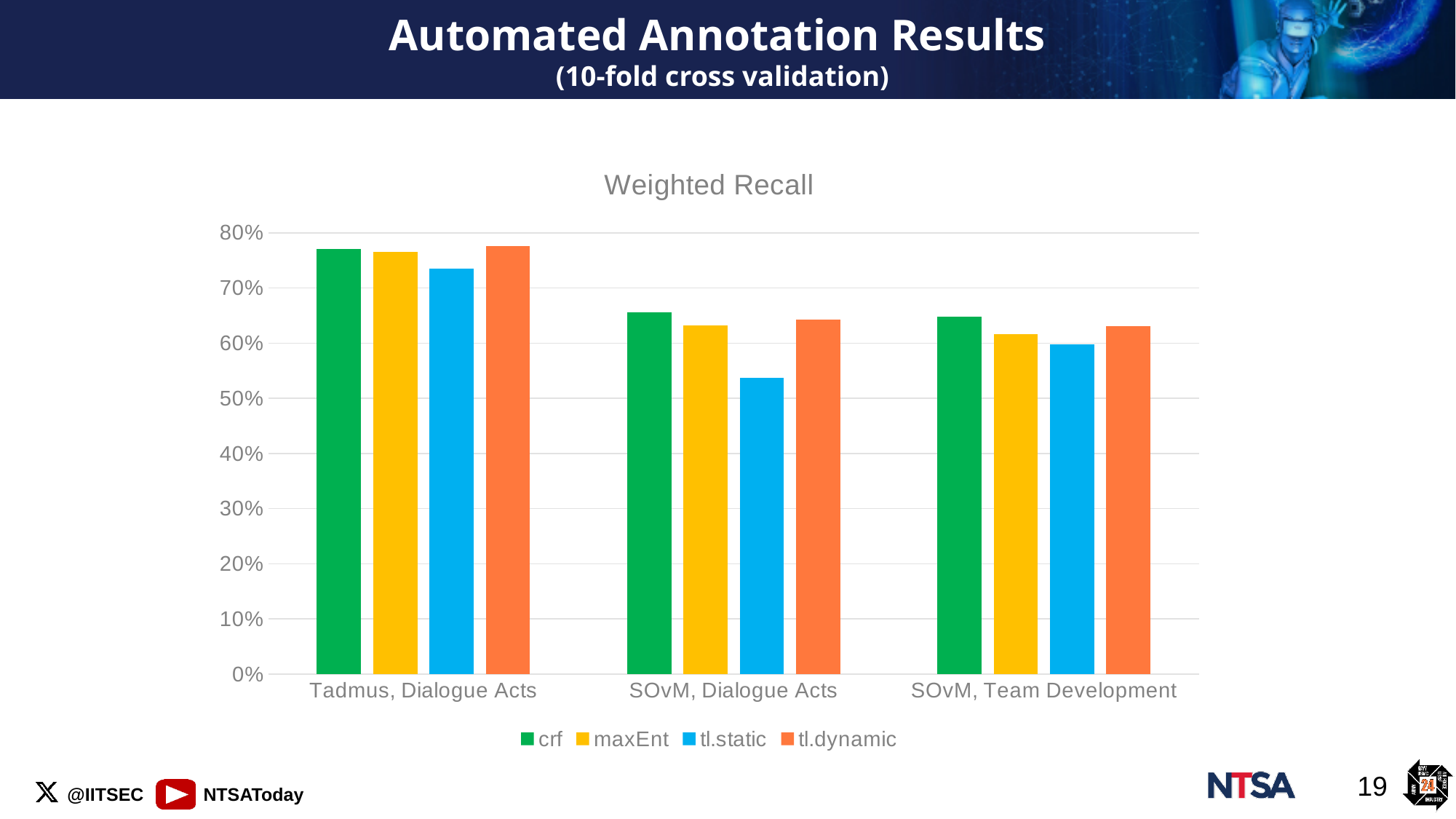
Is the tl.static value for SOvM, Dialogue Acts greater or less than 60%? less In the SOvM, Dialogue Acts category, which is larger: crf or tl.static? crf Which series is shown in orange in the legend? tl.dynamic Which series has the lowest value in the SOvM, Dialogue Acts category? tl.static How many series does the legend list? 4 What kind of chart is shown on the slide? bar chart Which series has the lowest value in the Tadmus, Dialogue Acts category? tl.static How many categories are shown on the x axis? 3 Is the crf value for Tadmus, Dialogue Acts greater or less than 70%? greater Is the crf value for SOvM, Dialogue Acts greater or less than 70%? less What is the title of the chart? Weighted Recall Which series has the highest value in the SOvM, Team Development category? crf